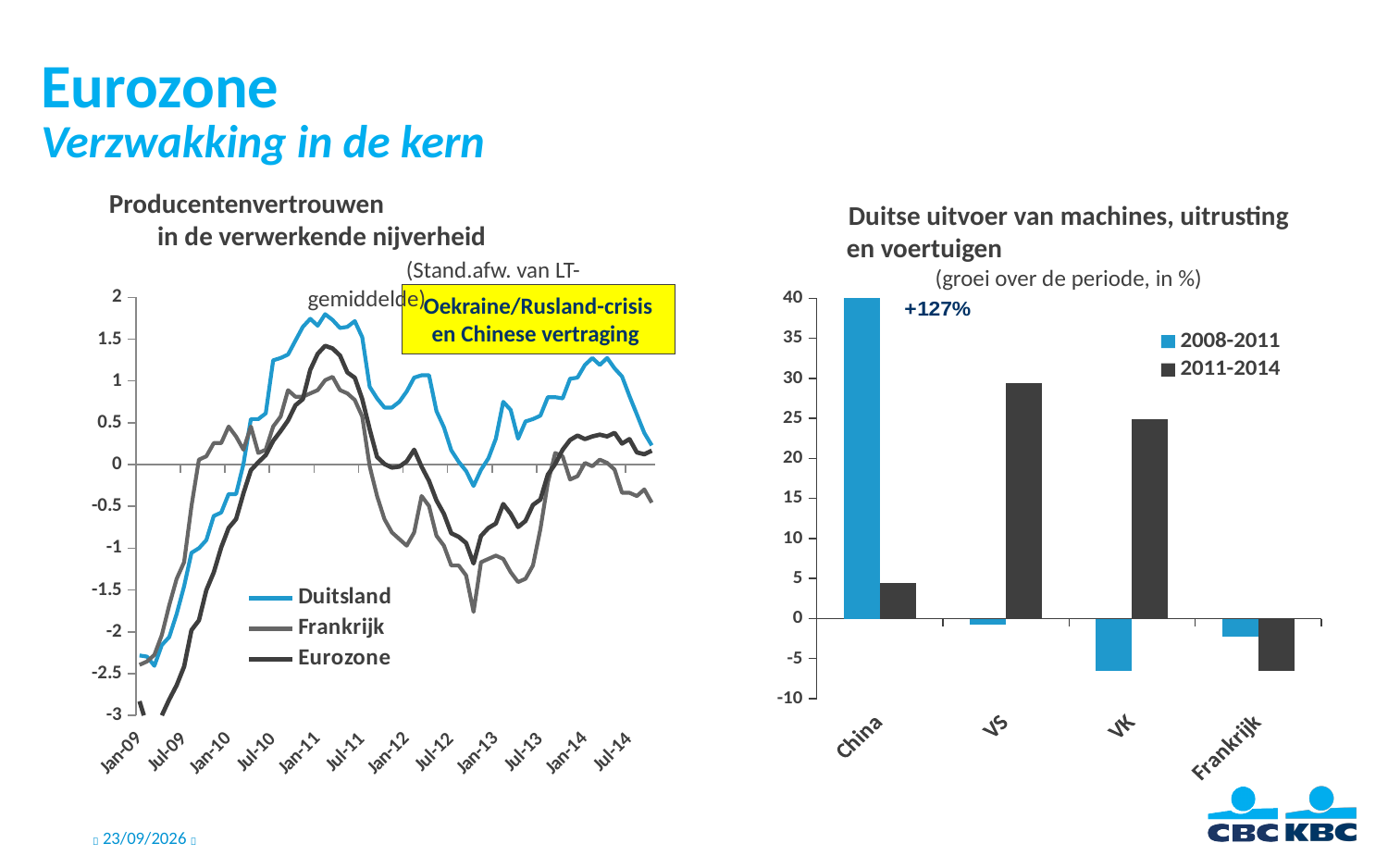
In the 'Duitse uitvoer' chart on the right, which is larger for 2011-2014: VS or VK? VS In the 'Duitse uitvoer' chart on the right, how many series does the legend list? 2 In the 'Duitse uitvoer' chart on the right, how many countries are shown on the x axis? 4 In the 'Duitse uitvoer' chart on the right, which country has the highest value for 2011-2014? VS What kind of chart is the 'Duitse uitvoer van machines, uitrusting en voertuigen' chart on the right? bar chart In the 'Duitse uitvoer' chart on the right, which country has the lowest value for 2011-2014? Frankrijk In the 'Duitse uitvoer' chart on the right, what growth value is printed for China for 2008-2011? +127% In the 'Producentenvertrouwen' chart on the left, how many series does the legend list? 3 What kind of chart is the 'Producentenvertrouwen in de verwerkende nijverheid' chart on the left? line chart In the 'Producentenvertrouwen' chart on the left, which series are listed in the legend? Duitsland, Frankrijk, Eurozone In the 'Duitse uitvoer' chart on the right, is the 2008-2011 value for VK greater or less than -5? less In the 'Duitse uitvoer' chart on the right, is the 2011-2014 value for VS greater or less than 25? greater